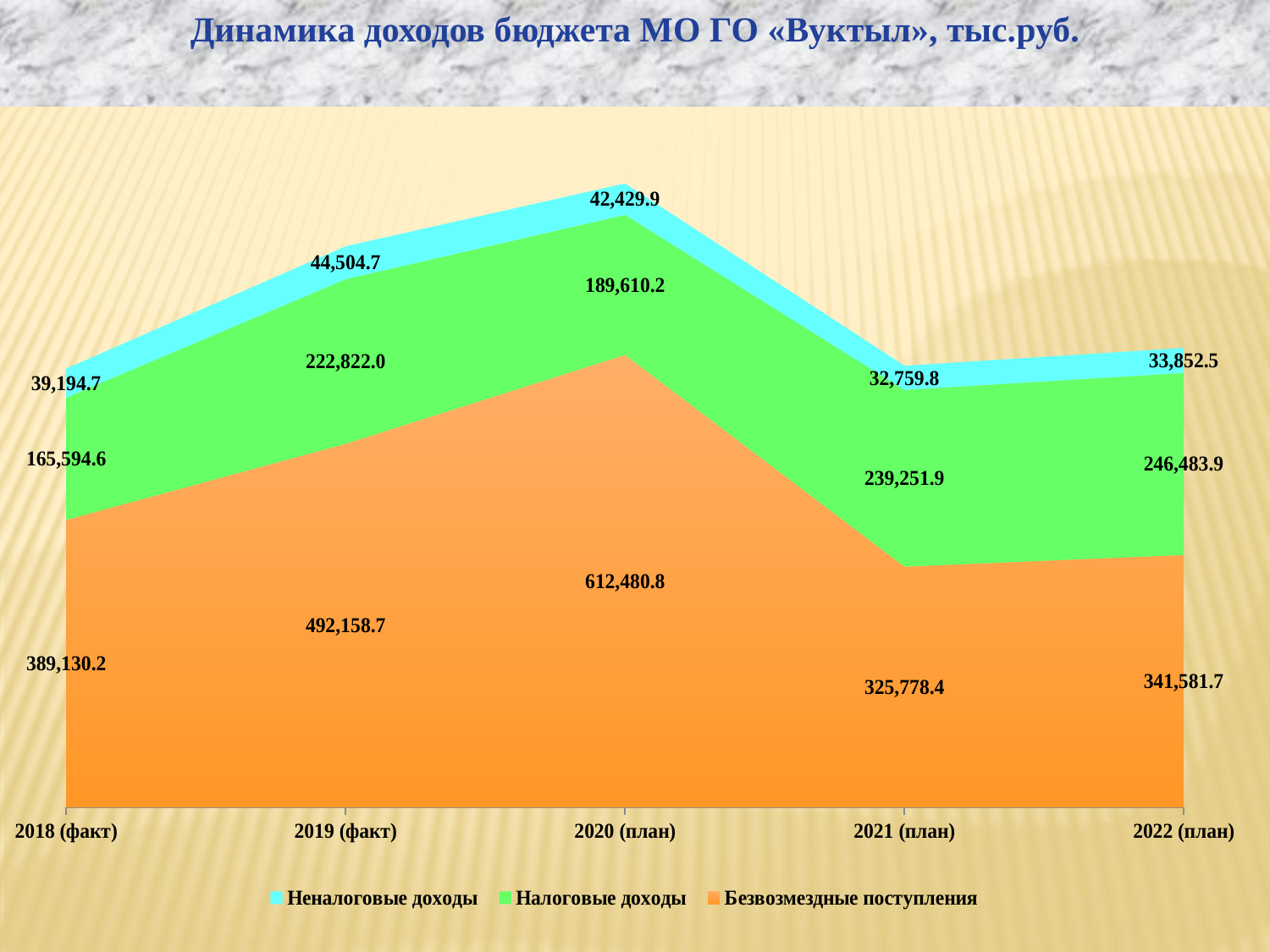
What is the value of Неналоговые доходы for 2022 (план)? 33,852.5 How many series does the legend list? 3 What is the value of Налоговые доходы for 2019 (факт)? 222,822.0 What is the value of Безвозмездные поступления for 2020 (план)? 612,480.8 What is the difference between Безвозмездные поступления in 2020 (план) and 2021 (план)? 286,702.4 In which year are Неналоговые доходы highest? 2019 (факт) What is the total of all three series for 2018 (факт)? 593,919.5 In which year are Безвозмездные поступления lowest? 2021 (план) Which series is shown in orange? Безвозмездные поступления Which is larger: Налоговые доходы in 2021 (план) or in 2022 (план)? 2022 (план) How many years are shown on the x axis? 5 What kind of chart is this? Stacked area chart